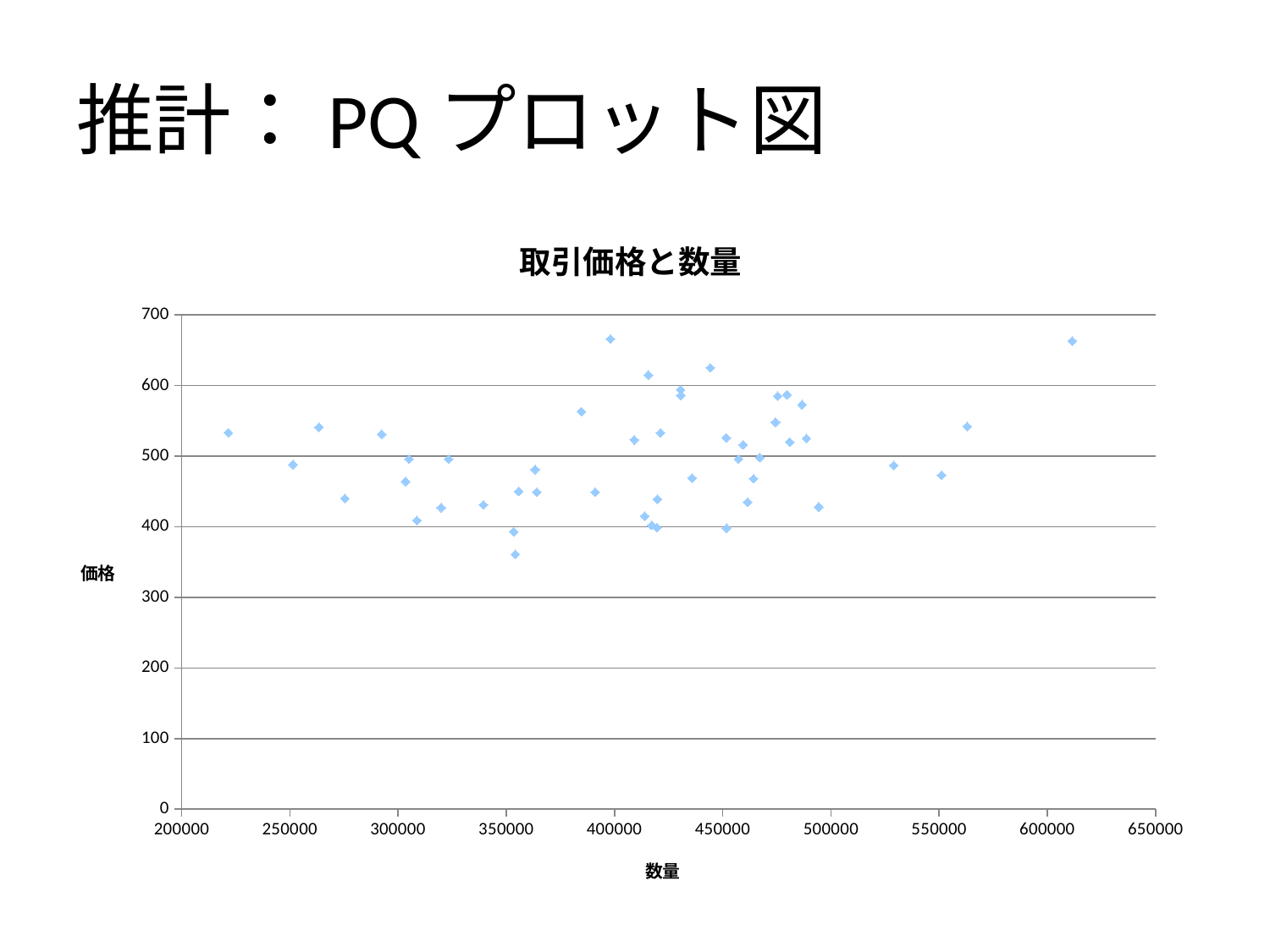
Is the 数量 of the rightmost point greater or less than 600000? greater What is the title of the chart? 取引価格と数量 What kind of chart is shown on the slide? scatter chart What are the labels of the x axis and the y axis of the chart? x axis: 数量, y axis: 価格 Is the 価格 of the point with the largest 数量 (the rightmost point) greater or less than 600? greater Is the highest 価格 value plotted on the chart greater or less than 600? greater Which has the higher 価格: the rightmost point or the leftmost point? the rightmost point